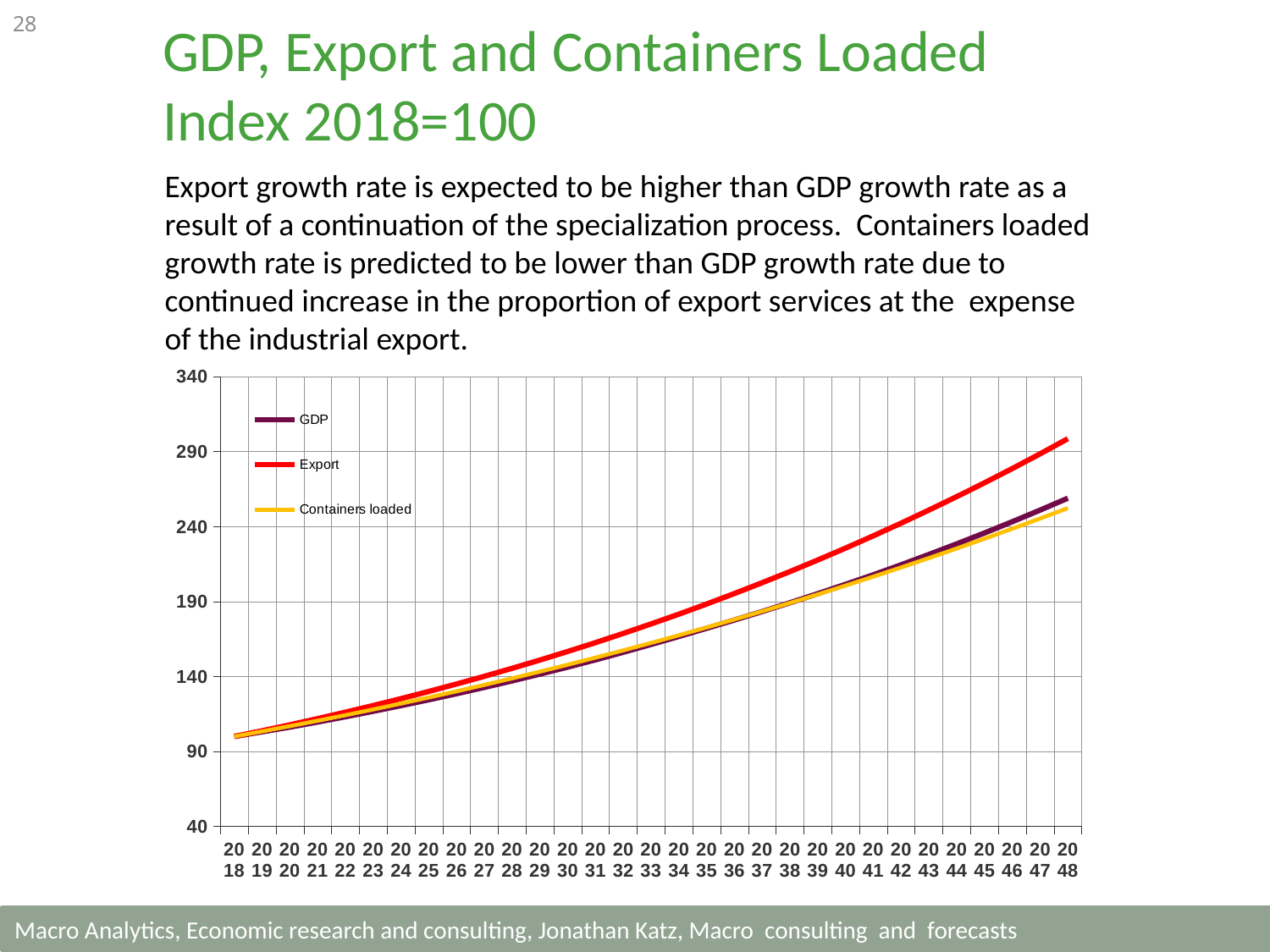
What kind of chart is shown on the slide? line chart Do the values of the Export series rise or fall from 2018 to 2048? rise What colour is the line for the Export series? red How many years are plotted along the x axis of the chart? 31 Which is larger in 2045, the value for Export or the value for GDP? Export How many series does the chart legend list? 3 Is the value for GDP in 2048 greater or less than 290? less Is the value for Export in 2048 greater or less than 290? greater Is the value for Containers loaded in 2048 greater or less than 240? greater Which series has the highest value in 2048? Export